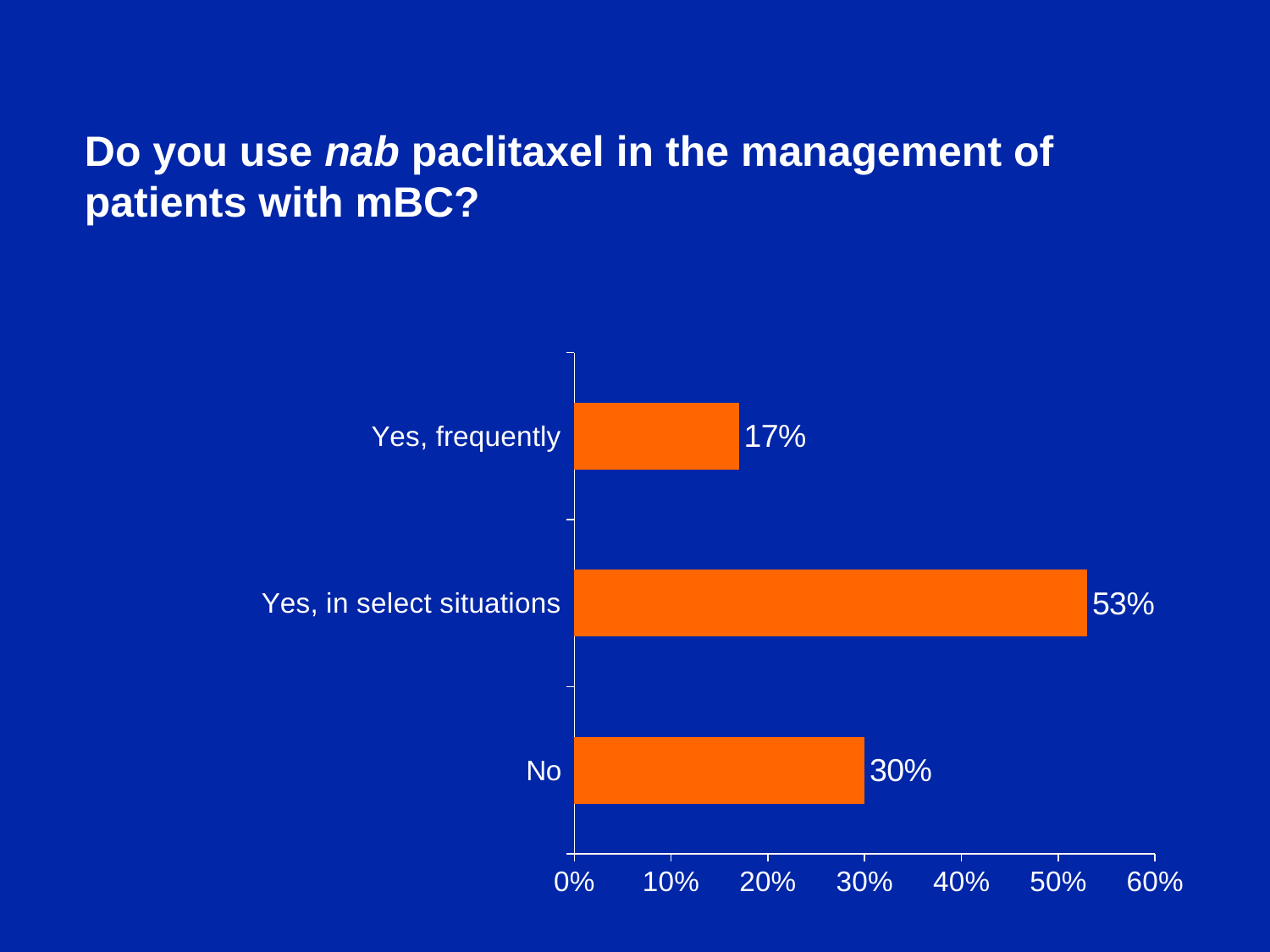
Is the value for "Yes, in select situations" greater or less than 50%? greater What percentage of respondents answered "Yes, frequently"? 17% Which response category has the highest percentage? Yes, in select situations What is the difference in percentage points between "No" and "Yes, frequently"? 13 What type of chart is shown on the slide? Bar chart What is the maximum value shown on the horizontal axis? 60% What percentage of respondents answered "Yes, in select situations"? 53% What percentage of respondents answered "No"? 30% Which response category has the lowest percentage? Yes, frequently How many response categories are shown in the chart? 3 Which is larger, the percentage for "No" or for "Yes, frequently"? No What is the difference in percentage points between "Yes, in select situations" and "No"? 23